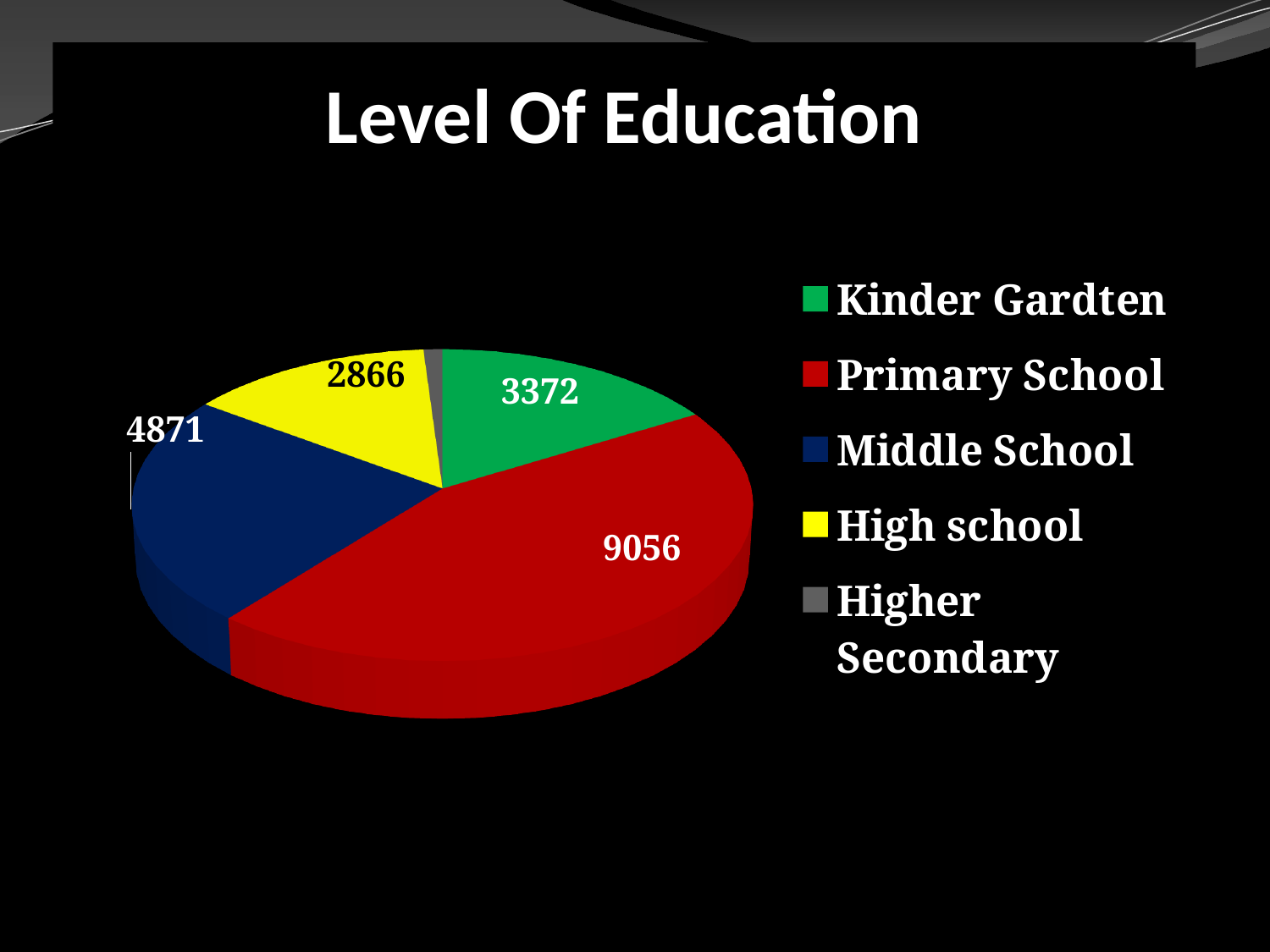
How many categories does the pie chart show? 5 What is the difference between the values for Primary School and Middle School? 4185 What is the value for High school in the pie chart? 2866 What kind of chart is shown on the slide? Pie chart What is the difference between the values for Middle School and Kinder Gardten? 1499 Which level of education has the smallest slice of the pie chart? Higher Secondary What is the value for Middle School in the pie chart? 4871 Which level of education has the largest slice of the pie chart? Primary School What is the value for Primary School in the pie chart? 9056 What is the value for Kinder Gardten in the pie chart? 3372 What colour is the Primary School slice in the pie chart? Red Which is larger, the value for Kinder Gardten or the value for High school? Kinder Gardten